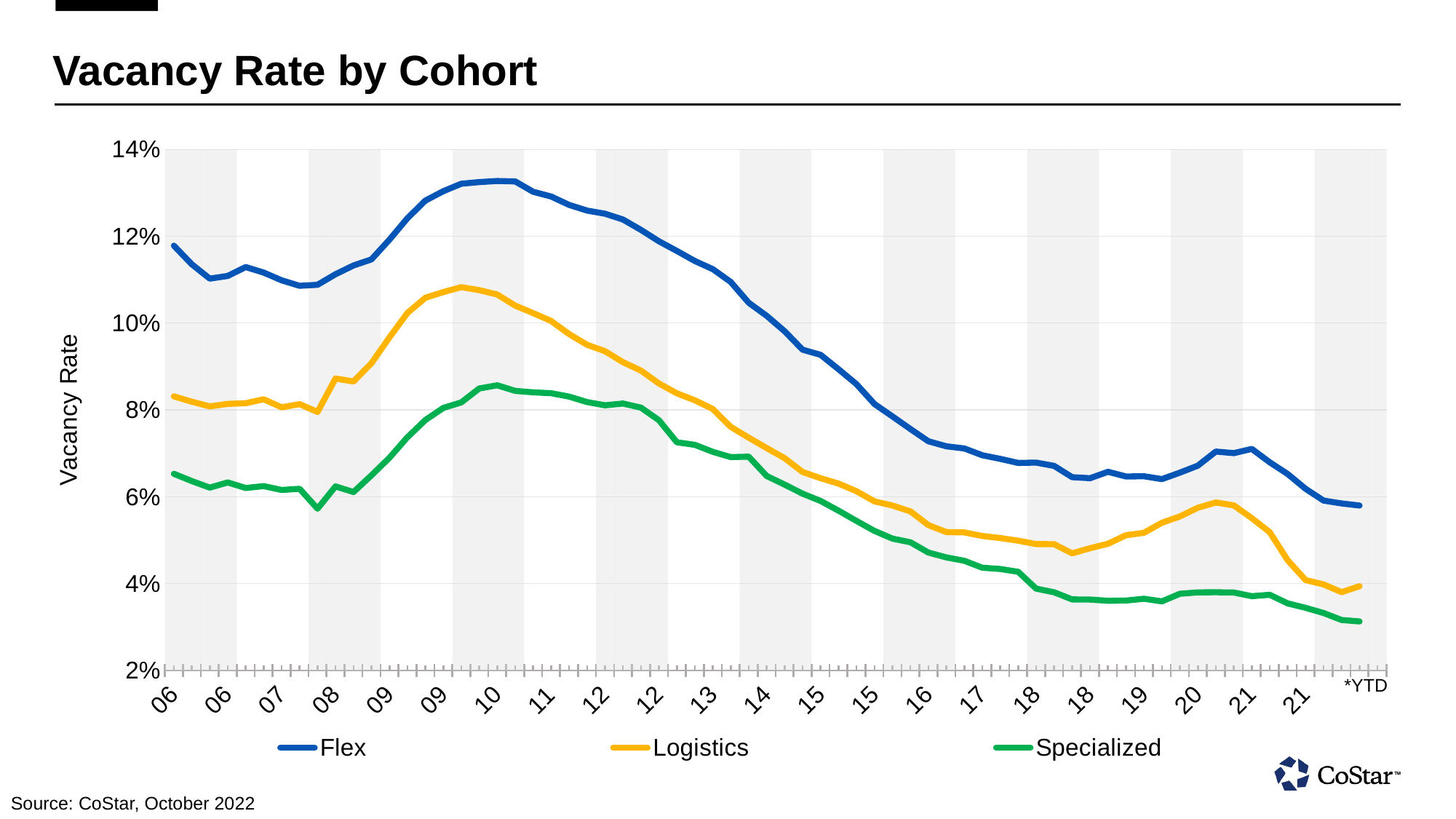
Around 2010, which is larger: the Flex vacancy rate or the Specialized vacancy rate? Flex Is the peak value of the Logistics series greater or less than 10%? greater Is the peak value of the Flex series greater or less than 12%? greater Is the value of the Specialized series at the end of the chart greater or less than 4%? less How many series does the legend list? 3 Does the Flex vacancy rate rise or fall from 2010 to 2021? fall Which series has the highest vacancy rate throughout the chart? Flex What is the label on the vertical axis? Vacancy Rate What is the title of the chart? Vacancy Rate by Cohort What kind of chart is shown on the slide? line chart Which series has the lowest vacancy rate throughout the chart? Specialized